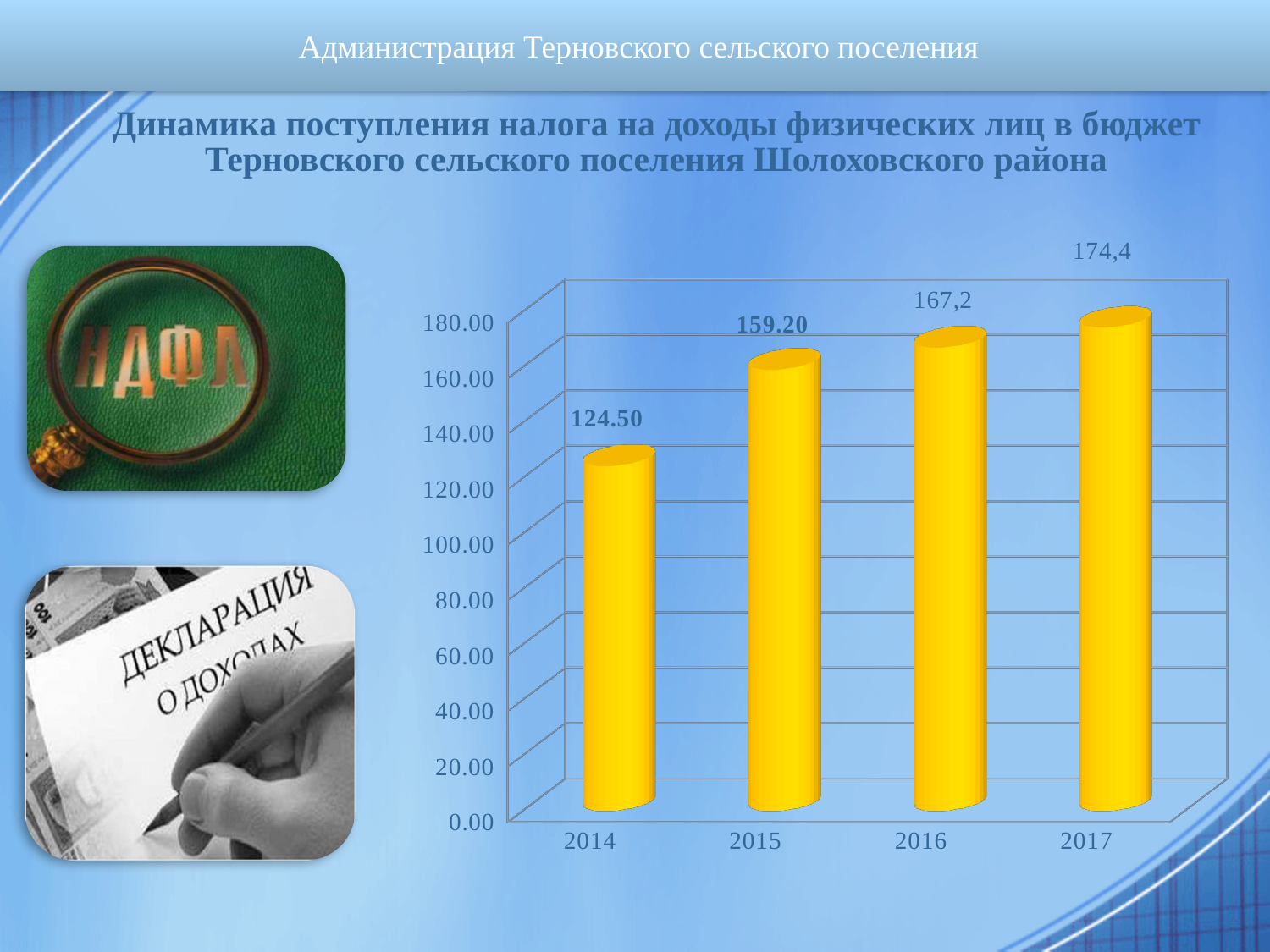
What is the difference between the values for 2017 and 2016? 7,2 What kind of chart is shown on the slide? bar chart What is the difference between the values for 2015 and 2014? 34.70 Which year has the lowest value? 2014 What is the value shown for 2014? 124.50 What is the value shown for 2017? 174,4 Which is larger, the value for 2015 or the value for 2016? 2016 Do the values rise or fall from 2014 to 2017? rise What is the value shown for 2016? 167,2 How many years are shown on the x axis? 4 What is the value shown for 2015? 159.20 Which year has the highest value? 2017